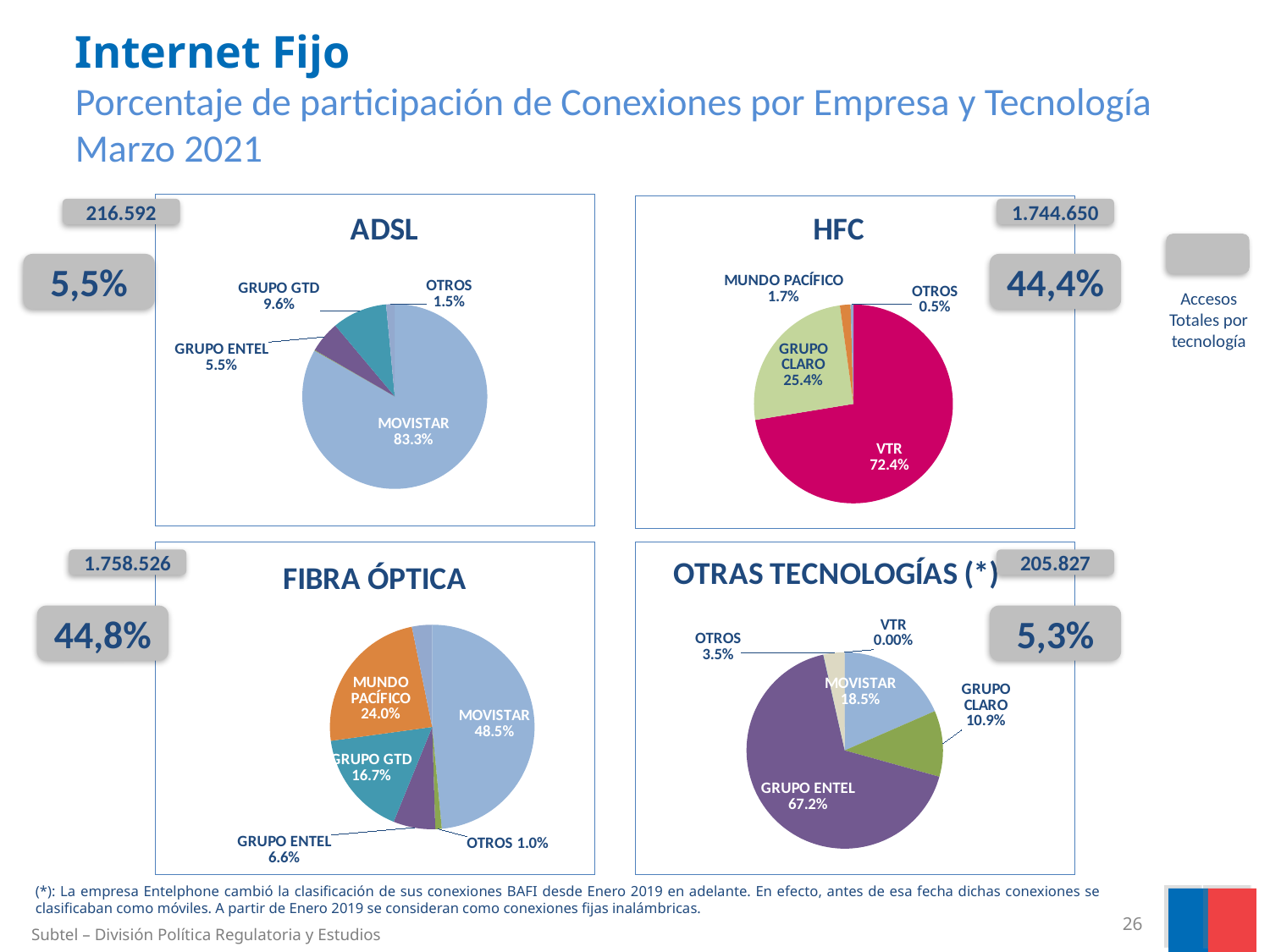
How many slices does the FIBRA ÓPTICA pie chart have? 6 In the HFC chart, what is the combined share of VTR and GRUPO CLARO? 97.8% In the FIBRA ÓPTICA chart, what share does MUNDO PACÍFICO have? 24.0% In the OTRAS TECNOLOGÍAS (*) chart, what share does VTR have? 0.00% In the ADSL chart, what share does MOVISTAR have? 83.3% How many pie charts are shown on the slide? 4 What type of chart is used for HFC? Pie chart In the OTRAS TECNOLOGÍAS (*) chart, which company has the largest slice? GRUPO ENTEL In the HFC chart, what share does GRUPO CLARO have? 25.4% In the ADSL chart, which is larger, the GRUPO GTD share or the GRUPO ENTEL share? GRUPO GTD In the HFC chart, which category has the smallest slice? OTROS In the FIBRA ÓPTICA chart, what is the difference between the MOVISTAR share and the GRUPO GTD share? 31.8%